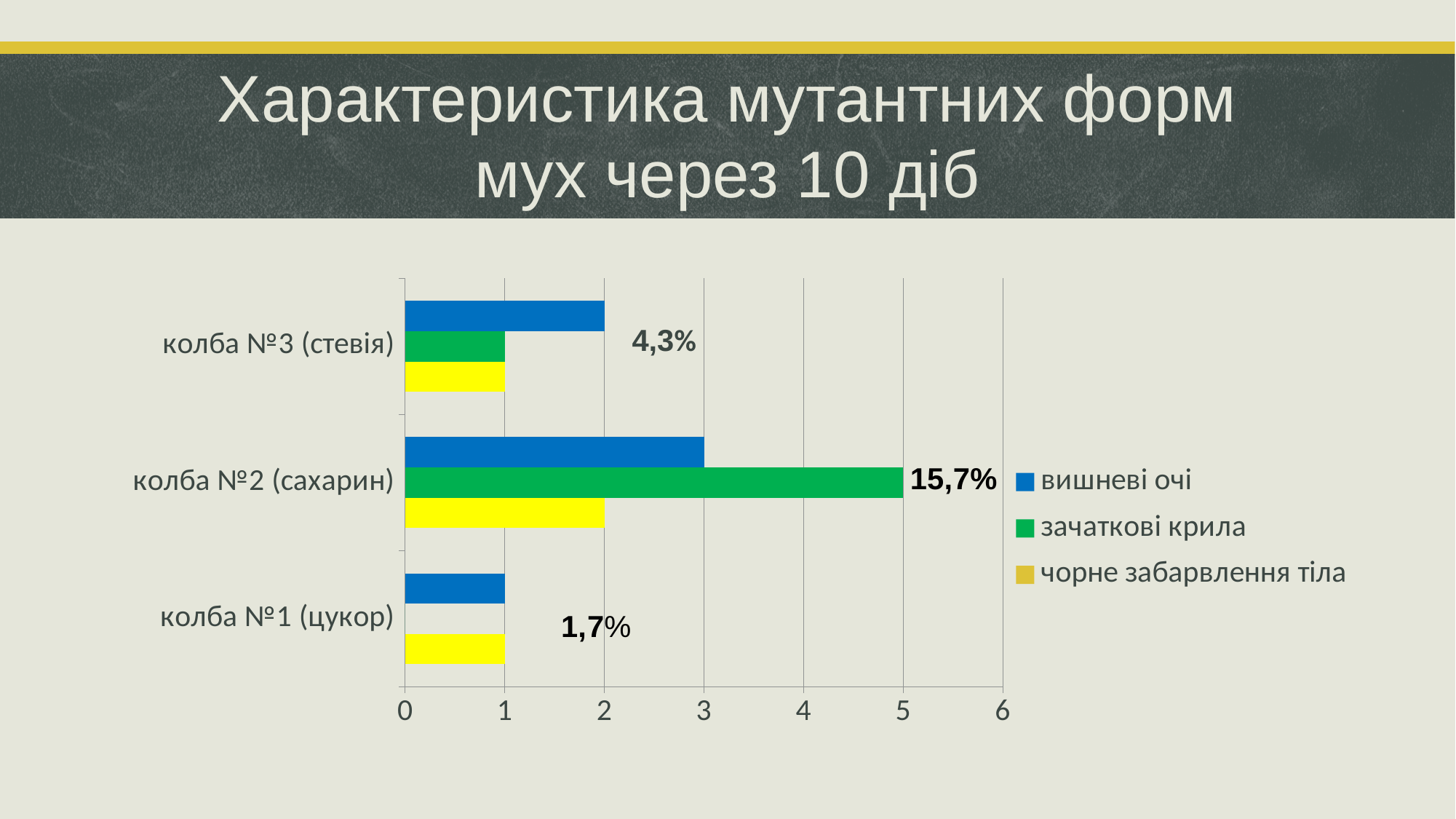
Which flask has the lowest value for вишневі очі? колба №1 (цукор) What is the value of чорне забарвлення тіла for колба №1 (цукор)? 1 What kind of chart is shown on the slide? bar chart Which is larger for колба №3 (стевія): вишневі очі or чорне забарвлення тіла? вишневі очі How many categories (flasks) are shown on the chart? 3 What is the value of вишневі очі for колба №2 (сахарин)? 3 What percentage label is shown next to колба №2 (сахарин)? 15,7% What is the value of зачаткові крила for колба №2 (сахарин)? 5 What is the value of вишневі очі for колба №3 (стевія)? 2 How many series does the legend list? 3 What is the difference between the зачаткові крила value and the вишневі очі value for колба №2 (сахарин)? 2 Which flask has the highest value for зачаткові крила? колба №2 (сахарин)